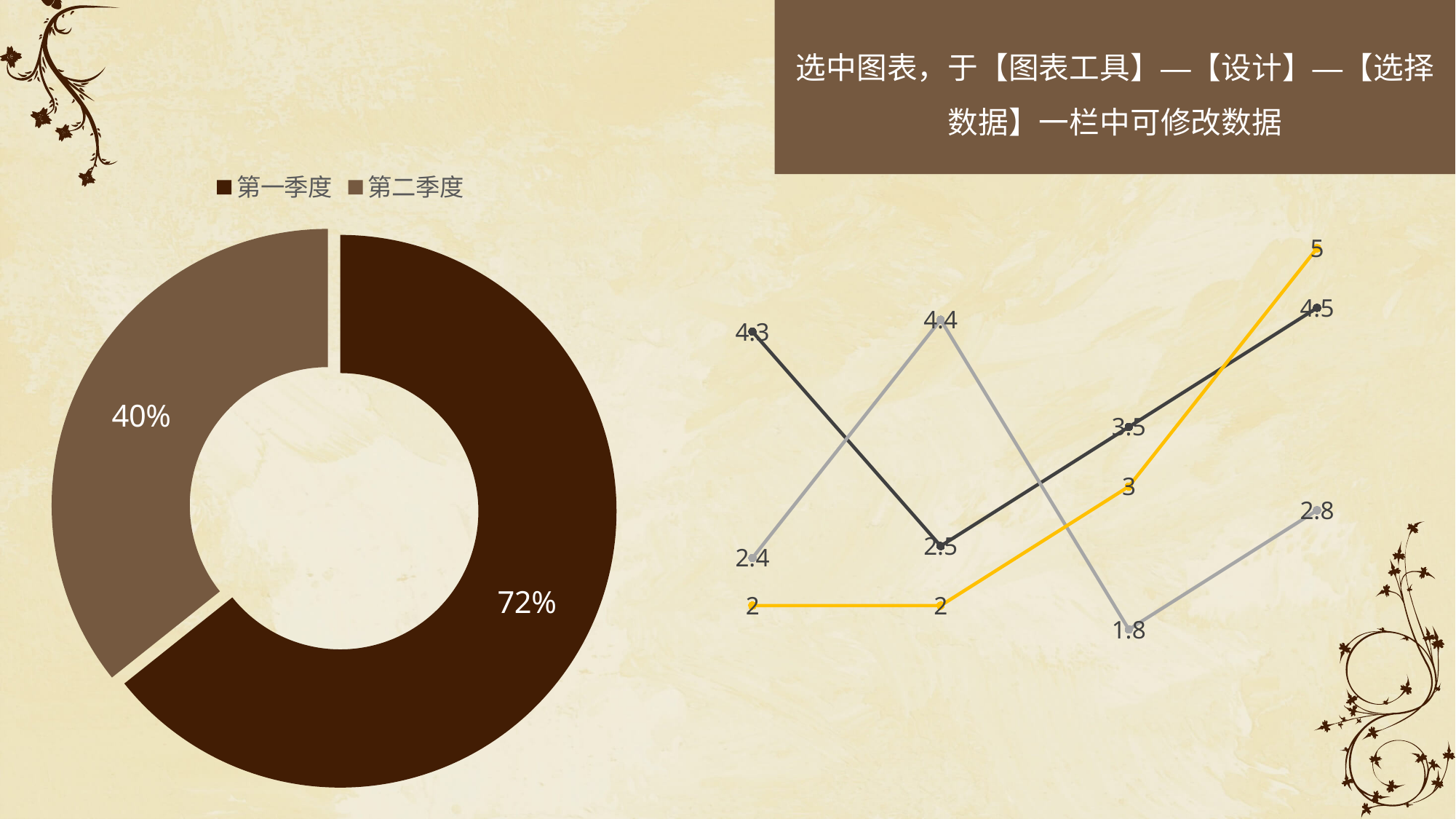
What kind of chart is shown on the left of the slide? Doughnut chart What kind of chart is shown on the right of the slide? Line chart How many entries does the legend of the chart on the left list? 2 How many data points does each line in the chart on the right have? 4 In the line chart on the right, what is the highest value on the yellow line? 5 How many lines are plotted in the chart on the right? 3 In the doughnut chart on the left, what is the value shown for 第二季度? 40% In the doughnut chart on the left, what is the value shown for 第一季度? 72% In the line chart on the right, what is the last (rightmost) value on the dark line? 4.5 In the line chart on the right, what is the lowest value on the light gray line? 1.8 In the doughnut chart on the left, what is the difference between the 第一季度 and 第二季度 values? 32% In the doughnut chart on the left, which category has the larger share, 第一季度 or 第二季度? 第一季度